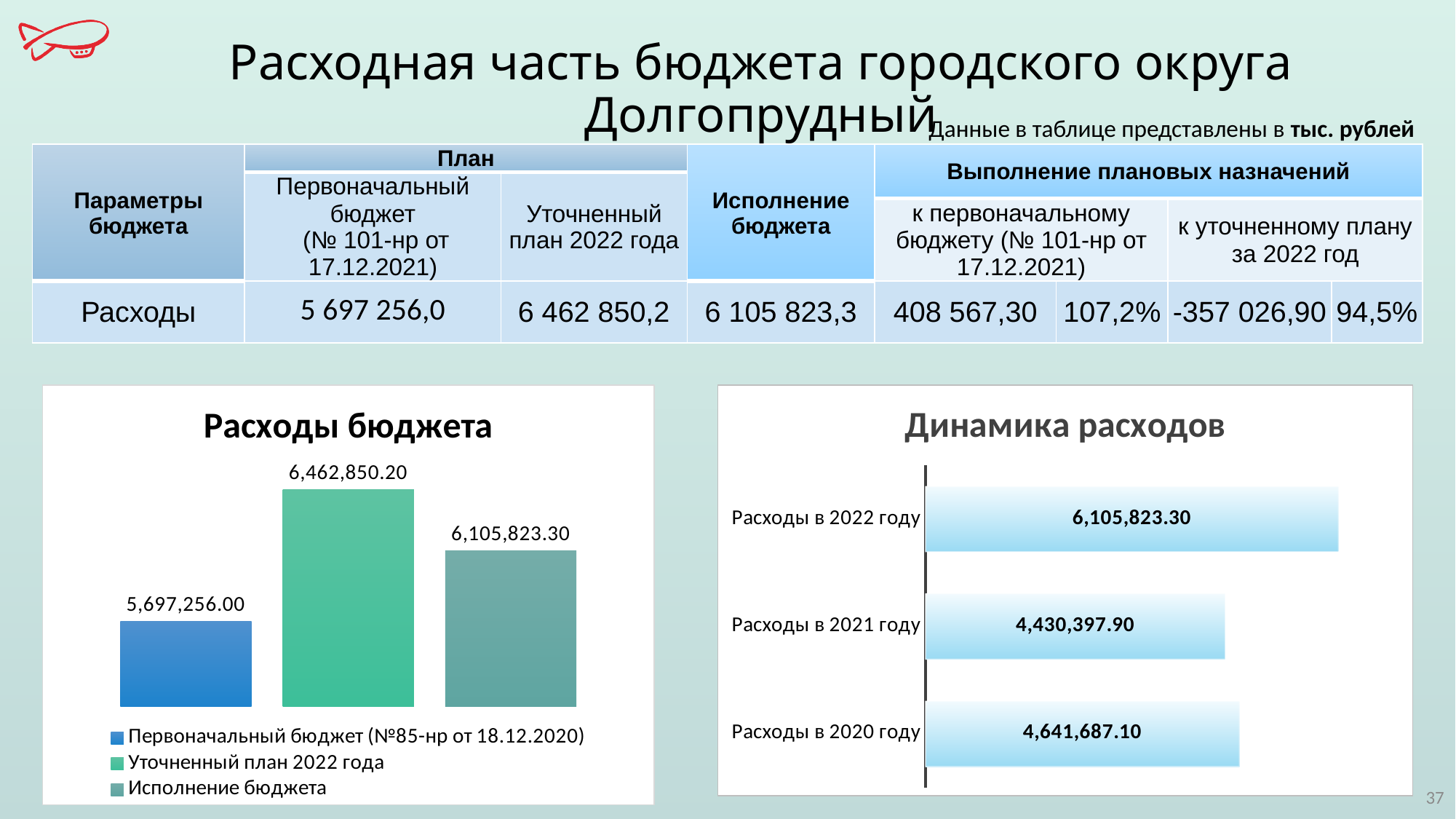
In the 'Расходы бюджета' chart, how many series does the legend list? 3 In the 'Расходы бюджета' chart, what is the value for 'Уточненный план 2022 года'? 6,462,850.20 How many bars are in the 'Динамика расходов' chart? 3 In the 'Динамика расходов' chart, what is the difference between 'Расходы в 2022 году' and 'Расходы в 2021 году'? 1,675,425.40 In the 'Динамика расходов' chart, what is the value for 'Расходы в 2021 году'? 4,430,397.90 What kind of chart is 'Расходы бюджета'? Bar chart In the 'Расходы бюджета' chart, what is the difference between 'Уточненный план 2022 года' and 'Исполнение бюджета'? 357,026.90 In the 'Динамика расходов' chart, what is the value for 'Расходы в 2020 году'? 4,641,687.10 In the 'Динамика расходов' chart, which year has the highest expenditure? Расходы в 2022 году In the 'Расходы бюджета' chart, which series has the lowest value? Первоначальный бюджет (№85-нр от 18.12.2020) In the 'Динамика расходов' chart, which is larger: 'Расходы в 2020 году' or 'Расходы в 2021 году'? Расходы в 2020 году In the 'Расходы бюджета' chart, what is the value for 'Исполнение бюджета'? 6,105,823.30